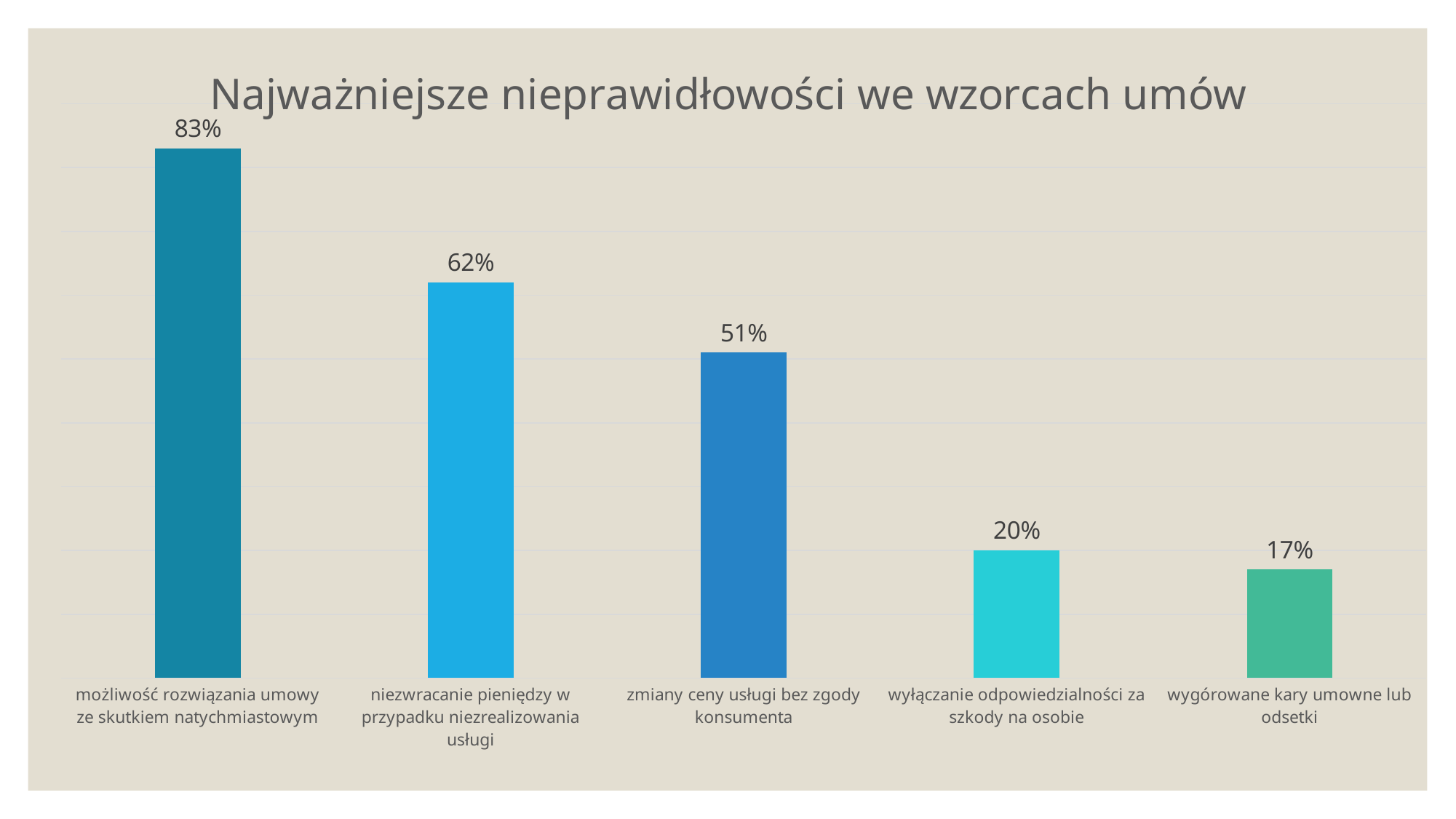
What is the value for 'możliwość rozwiązania umowy ze skutkiem natychmiastowym'? 83% How many categories are shown in the chart? 5 What is the title of the chart? Najważniejsze nieprawidłowości we wzorcach umów Do the values rise or fall from left to right across the categories? fall What is the value for 'zmiany ceny usługi bez zgody konsumenta'? 51% Which is larger: the value for 'niezwracanie pieniędzy w przypadku niezrealizowania usługi' or for 'zmiany ceny usługi bez zgody konsumenta'? niezwracanie pieniędzy w przypadku niezrealizowania usługi Which category has the highest value? możliwość rozwiązania umowy ze skutkiem natychmiastowym What is the value for 'wygórowane kary umowne lub odsetki'? 17% What kind of chart is shown on the slide? bar chart Which category has the lowest value? wygórowane kary umowne lub odsetki What is the difference between the values for 'możliwość rozwiązania umowy ze skutkiem natychmiastowym' and 'niezwracanie pieniędzy w przypadku niezrealizowania usługi'? 21% What is the difference between the values for 'wyłączanie odpowiedzialności za szkody na osobie' and 'wygórowane kary umowne lub odsetki'? 3%